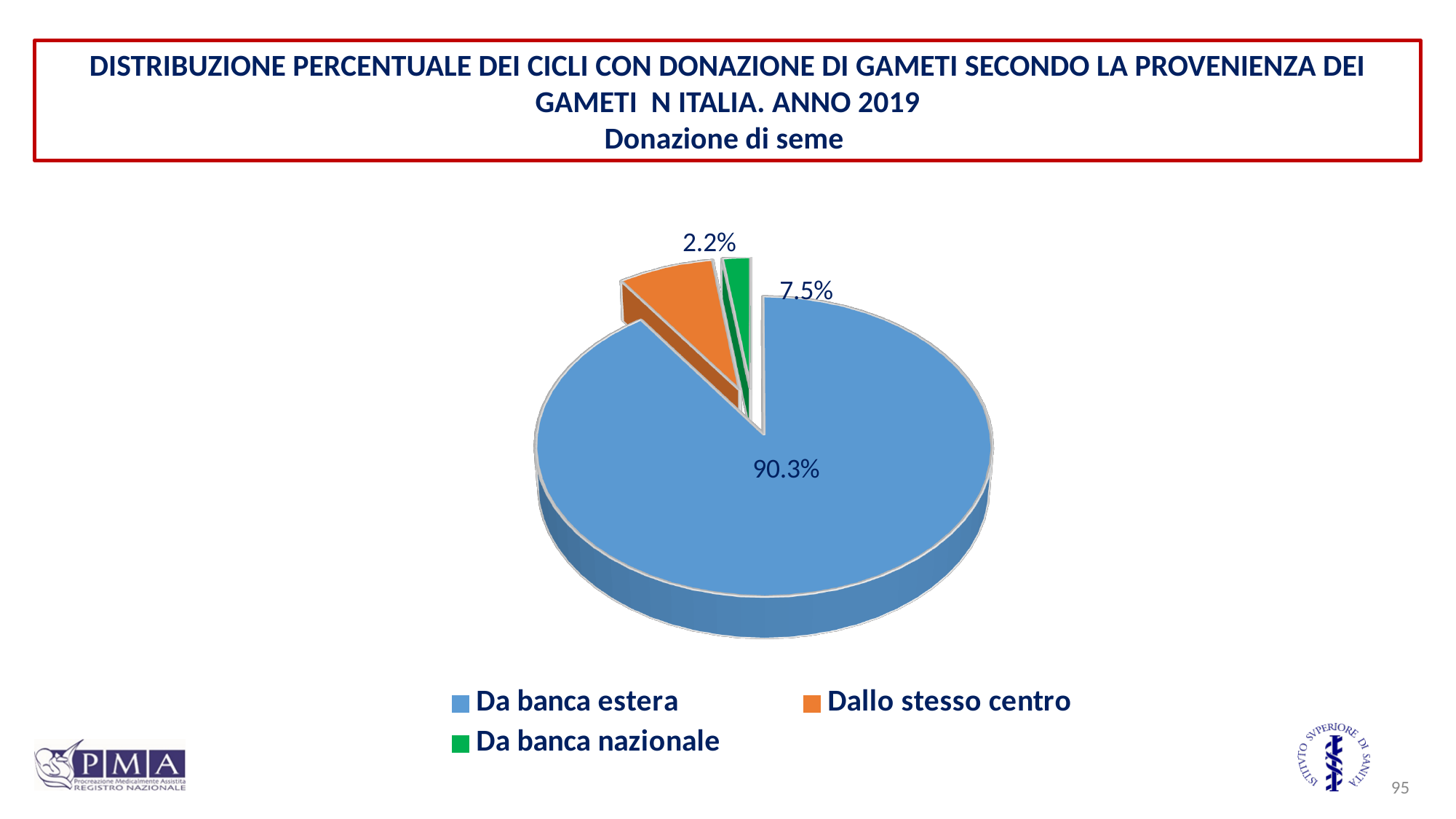
Which is larger, the share for Dallo stesso centro or the share for Da banca nazionale? Dallo stesso centro Which source accounts for the largest share of the pie? Da banca estera Which source accounts for the smallest share of the pie? Da banca nazionale What year does the chart title refer to? 2019 Which colour represents Dallo stesso centro in the legend? orange What is the difference in percentage points between Da banca estera and Dallo stesso centro? 82.8 What percentage of cycles used semen from a national bank (Da banca nazionale)? 2.2% What kind of chart is shown on the slide? pie chart What is the difference in percentage points between Dallo stesso centro and Da banca nazionale? 5.3 What percentage of cycles used semen from the same centre (Dallo stesso centro)? 7.5% What percentage of cycles used semen from a foreign bank (Da banca estera)? 90.3% How many categories does the pie chart show? 3